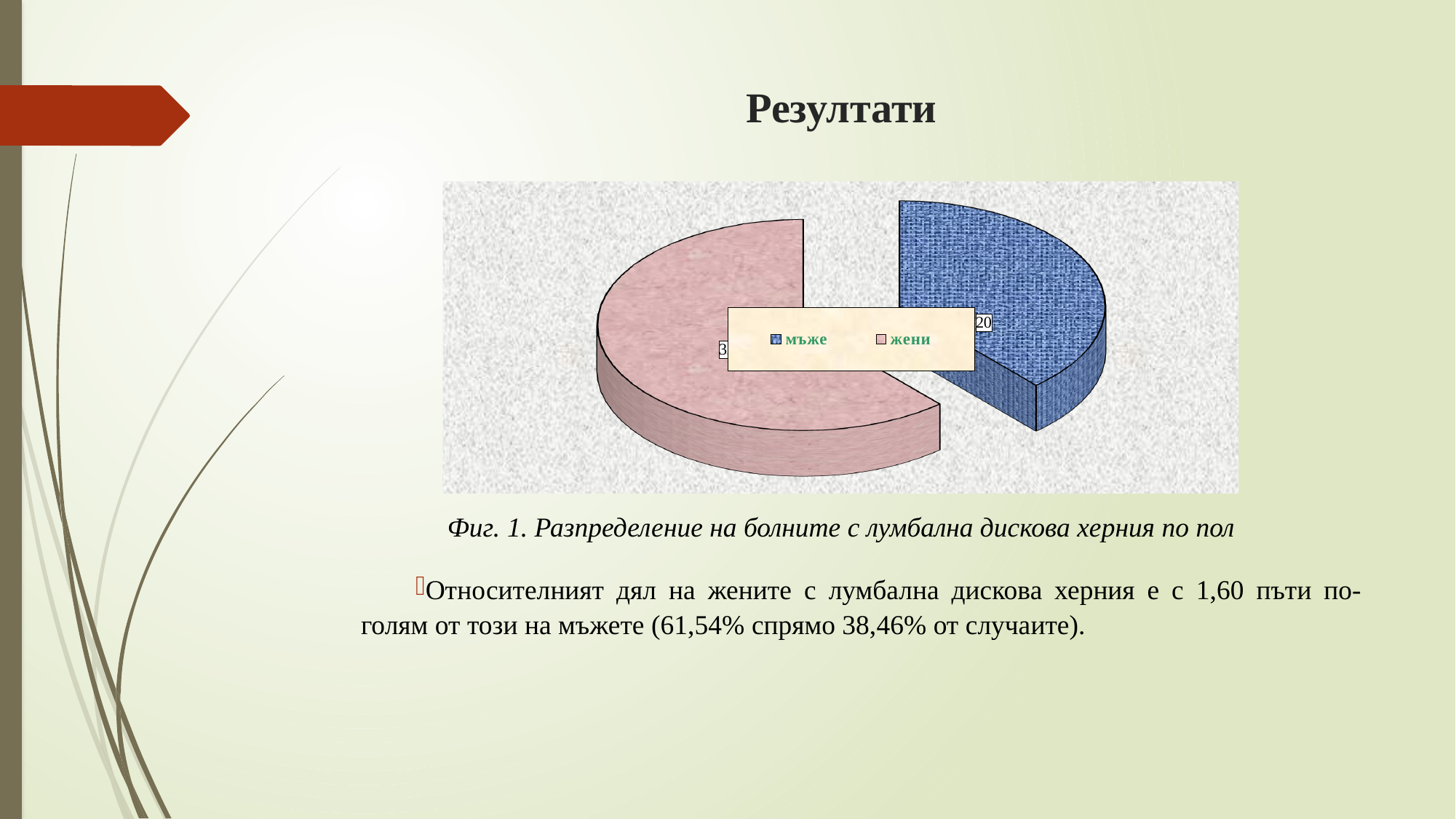
How many entries does the legend of the pie chart list? 2 Which category has the smallest slice in the pie chart? мъже Which slice is larger in the pie chart, мъже or жени? жени What kind of chart is shown on the slide? pie chart What colour is the мъже slice in the pie chart? blue How many slices does the pie chart have? 2 Which category has the largest slice in the pie chart? жени What is the value shown for мъже in the pie chart? 20 According to the slide, what share of the cases do мъже represent? 38,46% What are the two legend entries of the pie chart? мъже, жени